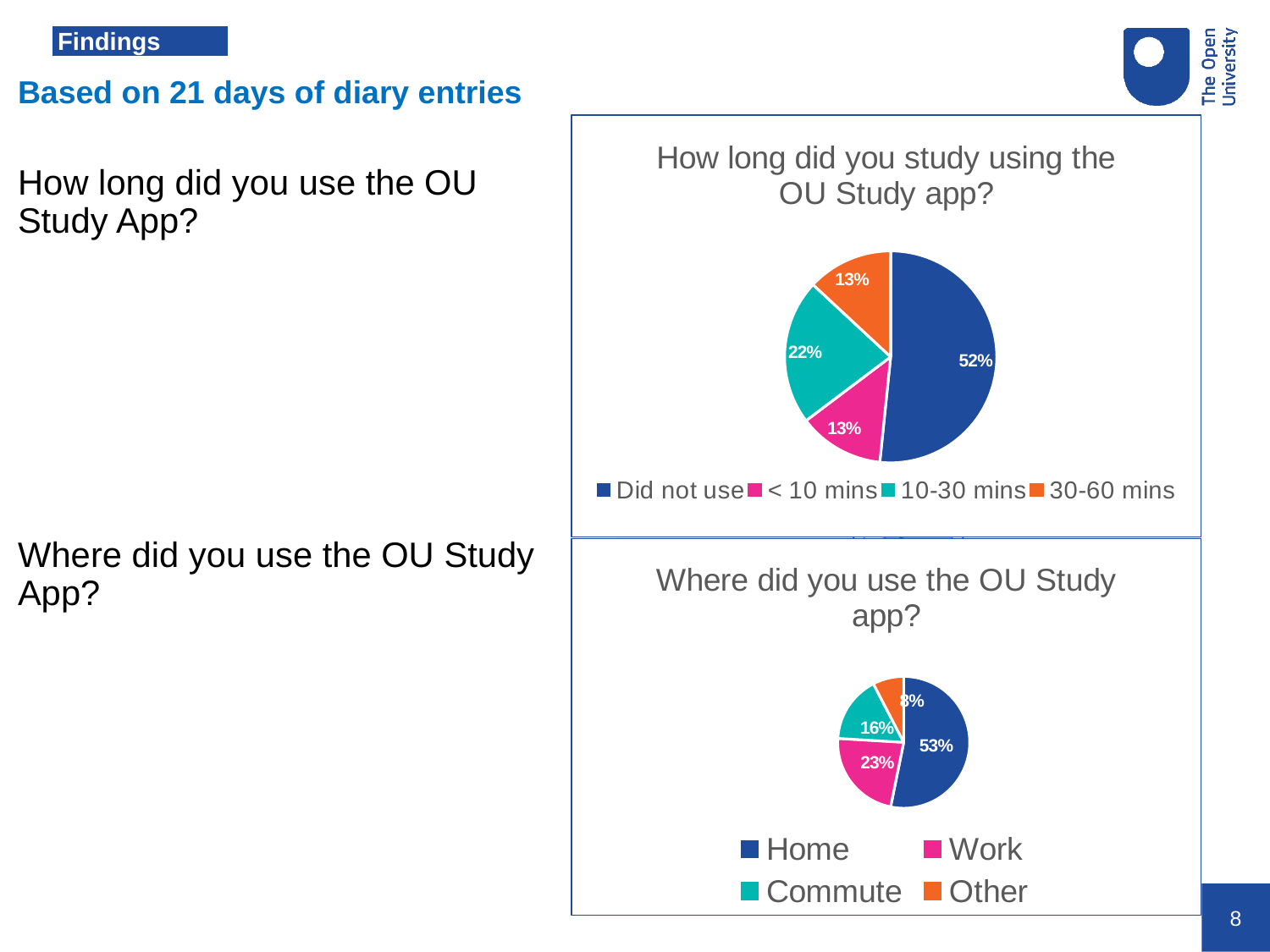
In the chart titled "How long did you study using the OU Study app?", what is the difference between the "Did not use" and "10-30 mins" slices? 30% In the chart titled "Where did you use the OU Study app?", what percentage is shown for "Work"? 23% In the chart titled "Where did you use the OU Study app?", what colour is the "Commute" slice? Teal In the chart titled "Where did you use the OU Study app?", which is larger, "Work" or "Commute"? Work In the chart titled "How long did you study using the OU Study app?", what share of the pie is "Did not use"? 52% In the chart titled "How long did you study using the OU Study app?", how many categories does the legend list? 4 What type of chart is the one titled "How long did you study using the OU Study app?"? Pie chart In the chart titled "Where did you use the OU Study app?", what share of the pie is "Home"? 53% In the chart titled "How long did you study using the OU Study app?", what percentage is shown for "10-30 mins"? 22% In the chart titled "How long did you study using the OU Study app?", which category has the largest slice? Did not use In the chart titled "Where did you use the OU Study app?", which category has the smallest slice? Other In the chart titled "Where did you use the OU Study app?", what is the difference between the "Home" and "Work" slices? 30%